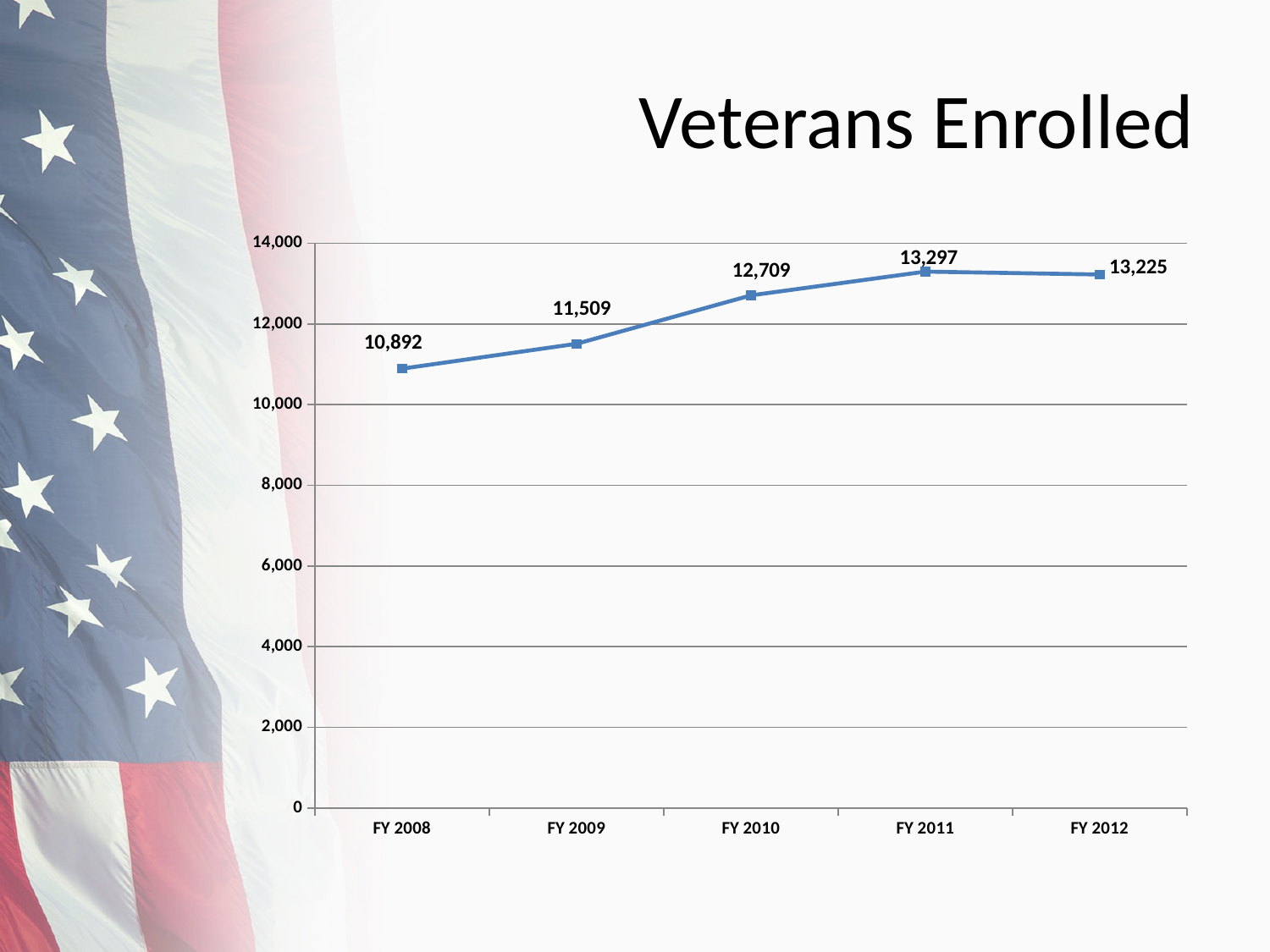
How many fiscal years are plotted on the chart? 5 Which fiscal year has the lowest number of veterans enrolled? FY 2008 What is the number of veterans enrolled in FY 2010? 12,709 Which year has more veterans enrolled, FY 2011 or FY 2012? FY 2011 What is the difference in veterans enrolled between FY 2011 and FY 2008? 2,405 Which fiscal year has the highest number of veterans enrolled? FY 2011 What is the difference in veterans enrolled between FY 2010 and FY 2009? 1,200 What kind of chart is shown on the slide? line chart What is the title of the chart? Veterans Enrolled Is the value for FY 2009 greater or less than 12,000? less What is the number of veterans enrolled in FY 2008? 10,892 What is the number of veterans enrolled in FY 2012? 13,225